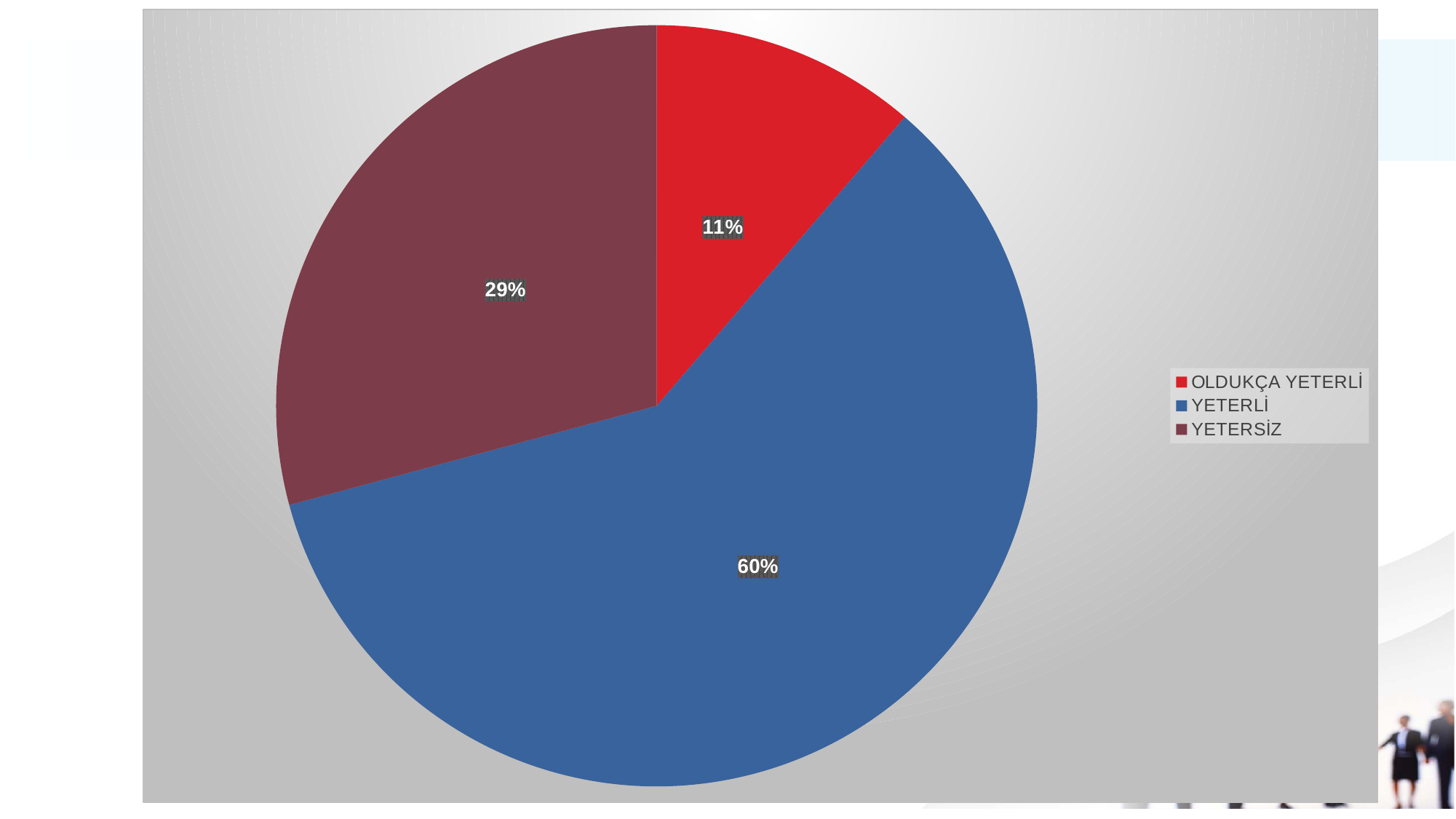
What kind of chart is shown on the slide? Pie chart What is the difference in percentage points between YETERSİZ and OLDUKÇA YETERLİ? 18 What share of the pie does YETERSİZ have? 29% What share of the pie does OLDUKÇA YETERLİ have? 11% What is the difference in percentage points between YETERLİ and YETERSİZ? 31 What colour is the YETERLİ slice? Blue Which category has the largest slice of the pie? YETERLİ Which is larger, the share for YETERSİZ or the share for OLDUKÇA YETERLİ? YETERSİZ How many categories does the pie chart have? 3 Which category has the smallest slice of the pie? OLDUKÇA YETERLİ Which legend entry is shown in red? OLDUKÇA YETERLİ What share of the pie does YETERLİ have? 60%